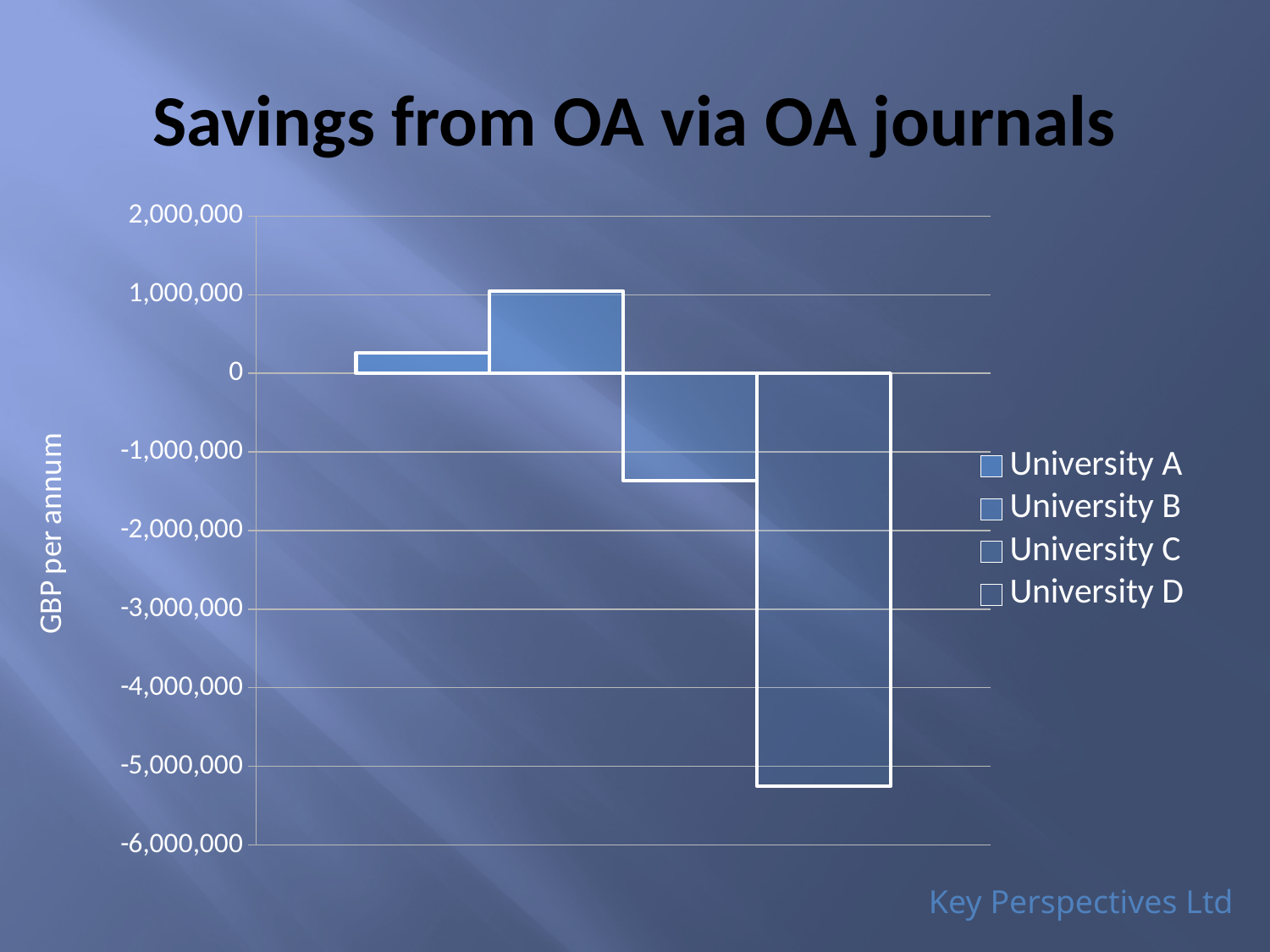
Is the value for University D greater or less than -5,000,000? less What kind of chart is shown on the slide? bar chart Which is larger, the value for University C or the value for University D? University C What is the label on the vertical axis? GBP per annum How many series does the legend list? 4 Which university has the lowest savings value? University D Which is larger, the value for University A or the value for University B? University B Which university has the highest savings value? University B How many bars are plotted in the chart? 4 Is the value for University A greater or less than 1,000,000? less What is the title of the chart? Savings from OA via OA journals Is the value for University C greater or less than -1,000,000? less